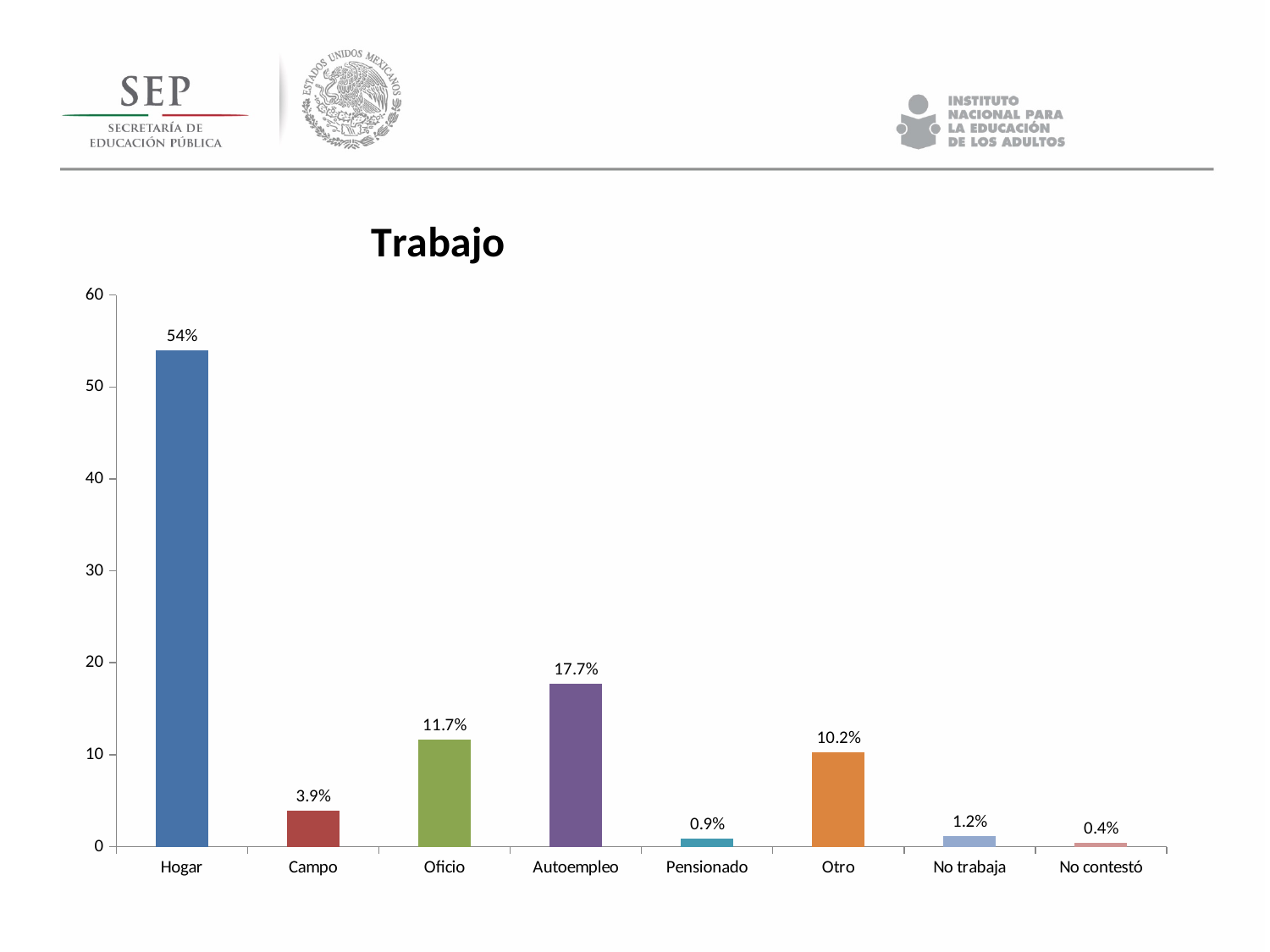
How many categories are shown on the x axis? 8 What kind of chart is shown on the slide? bar chart What is the value for No contestó? 0.4% What is the value for Pensionado? 0.9% What is the value for Hogar? 54% Which category has the highest value? Hogar What is the difference between the values for Autoempleo and Oficio? 6% What is the title of the chart? Trabajo What is the value for Autoempleo? 17.7% Which category has the lowest value? No contestó Which is larger, the value for Oficio or the value for Otro? Oficio Is the value for Hogar greater or less than 50? greater